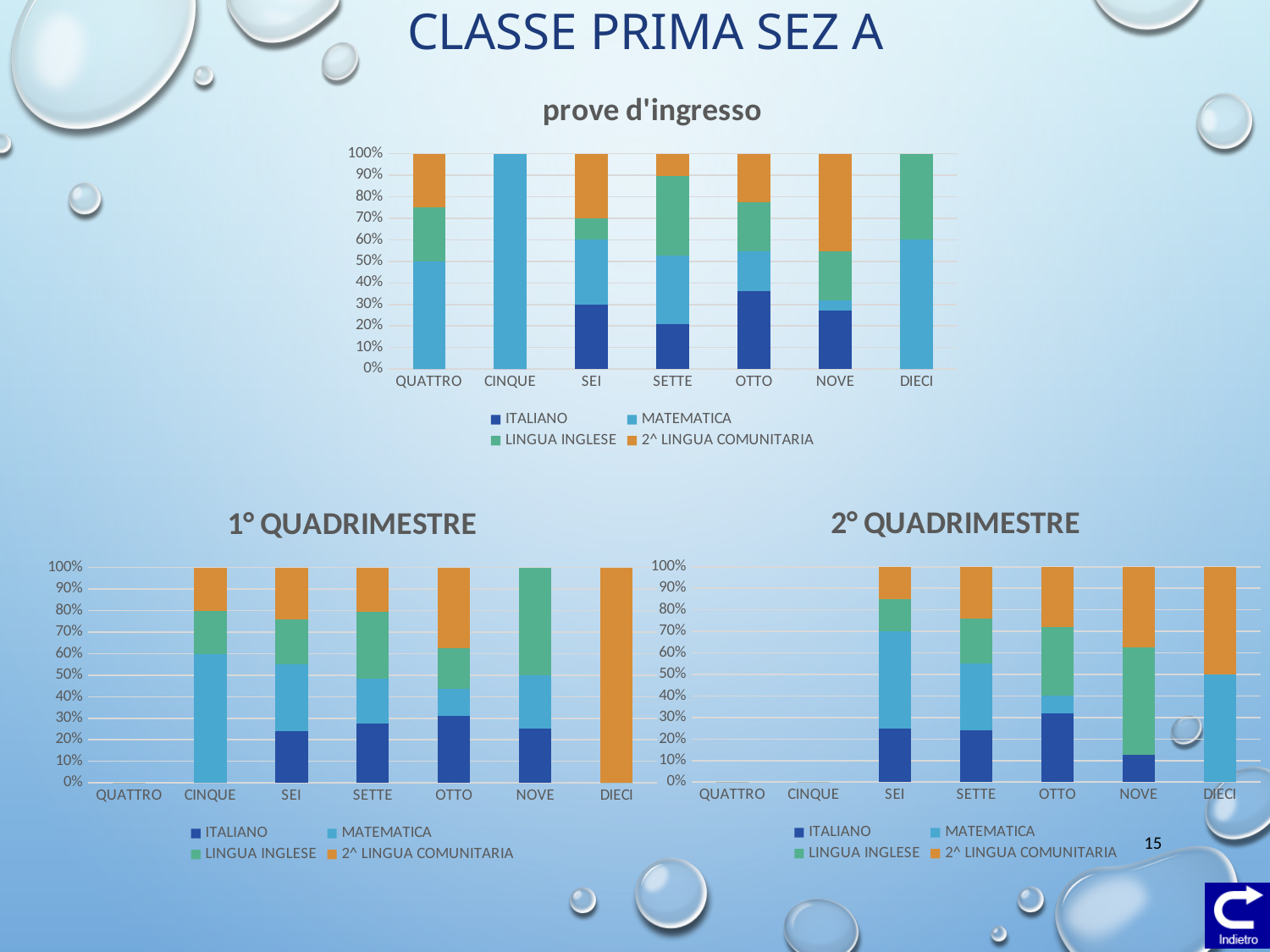
What kind of chart is the 'prove d'ingresso' chart? bar chart In the 'prove d'ingresso' chart, which series makes up the entire bar for CINQUE? MATEMATICA In the '1° QUADRIMESTRE' chart, which series makes up the entire bar for DIECI? 2^ LINGUA COMUNITARIA How many categories are shown on the x axis of the 'prove d'ingresso' chart? 7 In the '2° QUADRIMESTRE' chart, is the 2^ LINGUA COMUNITARIA share for DIECI greater or less than 40%? greater What is the title of the chart at the top of the slide? prove d'ingresso Which series is shown in orange in the '2° QUADRIMESTRE' chart legend? 2^ LINGUA COMUNITARIA In the '2° QUADRIMESTRE' chart, is the ITALIANO share for NOVE greater or less than 20%? less In the '1° QUADRIMESTRE' chart, is the MATEMATICA share for CINQUE greater or less than 50%? greater How many series does the legend of the '1° QUADRIMESTRE' chart list? 4